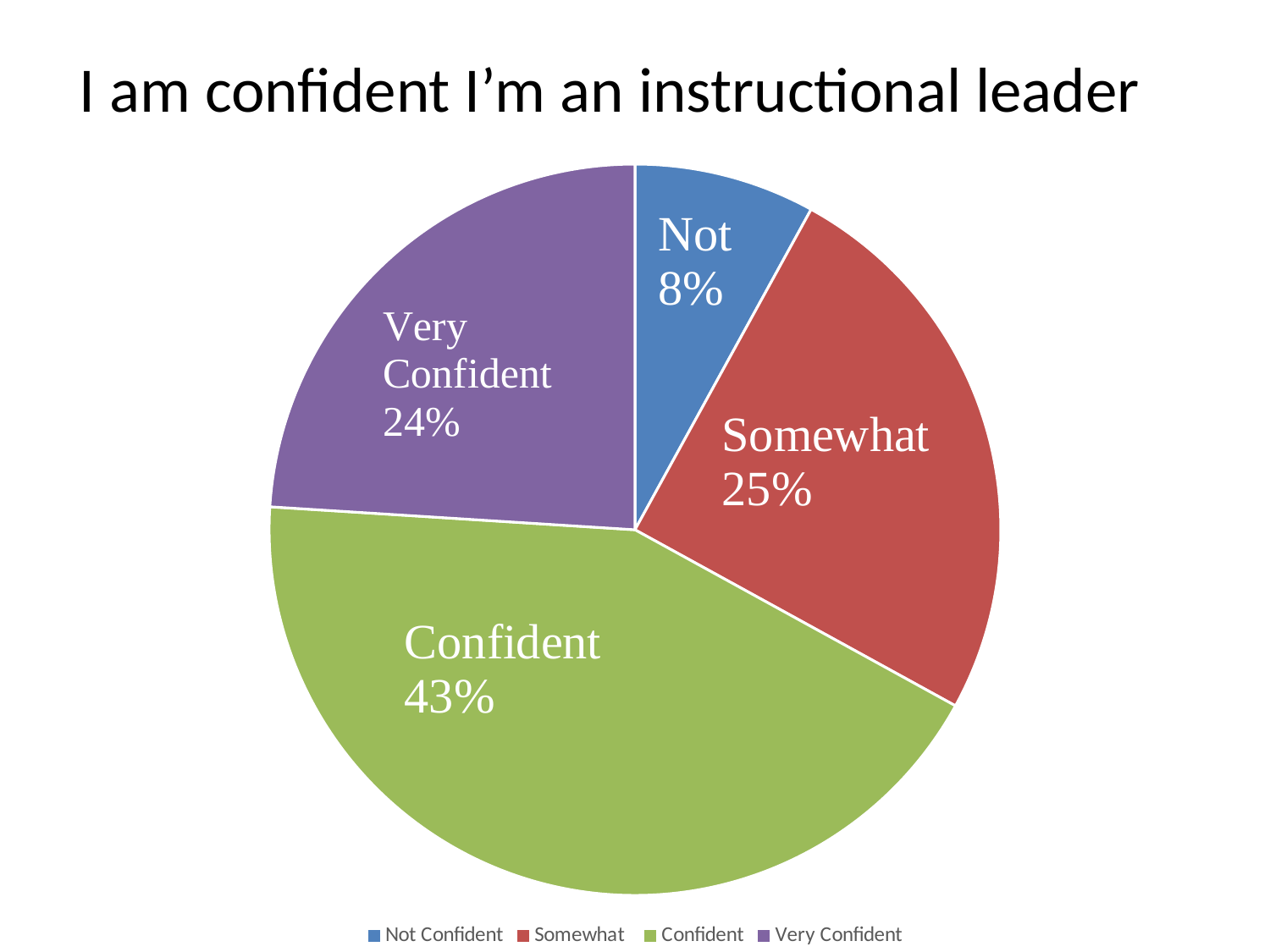
What percentage is shown for the Not Confident slice? 8% Which category has the smallest slice of the pie? Not Confident How many slices does the pie chart have? 4 What percentage is shown for the Very Confident slice? 24% What percentage is shown for the Somewhat slice? 25% What type of chart is shown on the slide? Pie chart What is the difference in percentage points between the Confident and Not Confident slices? 35 Which slice is larger, Confident or Somewhat? Confident What is the difference in percentage points between the Somewhat and Very Confident slices? 1 Which category has the largest slice of the pie? Confident What is the title of the chart? I am confident I'm an instructional leader What share of the pie does the Confident slice represent? 43%